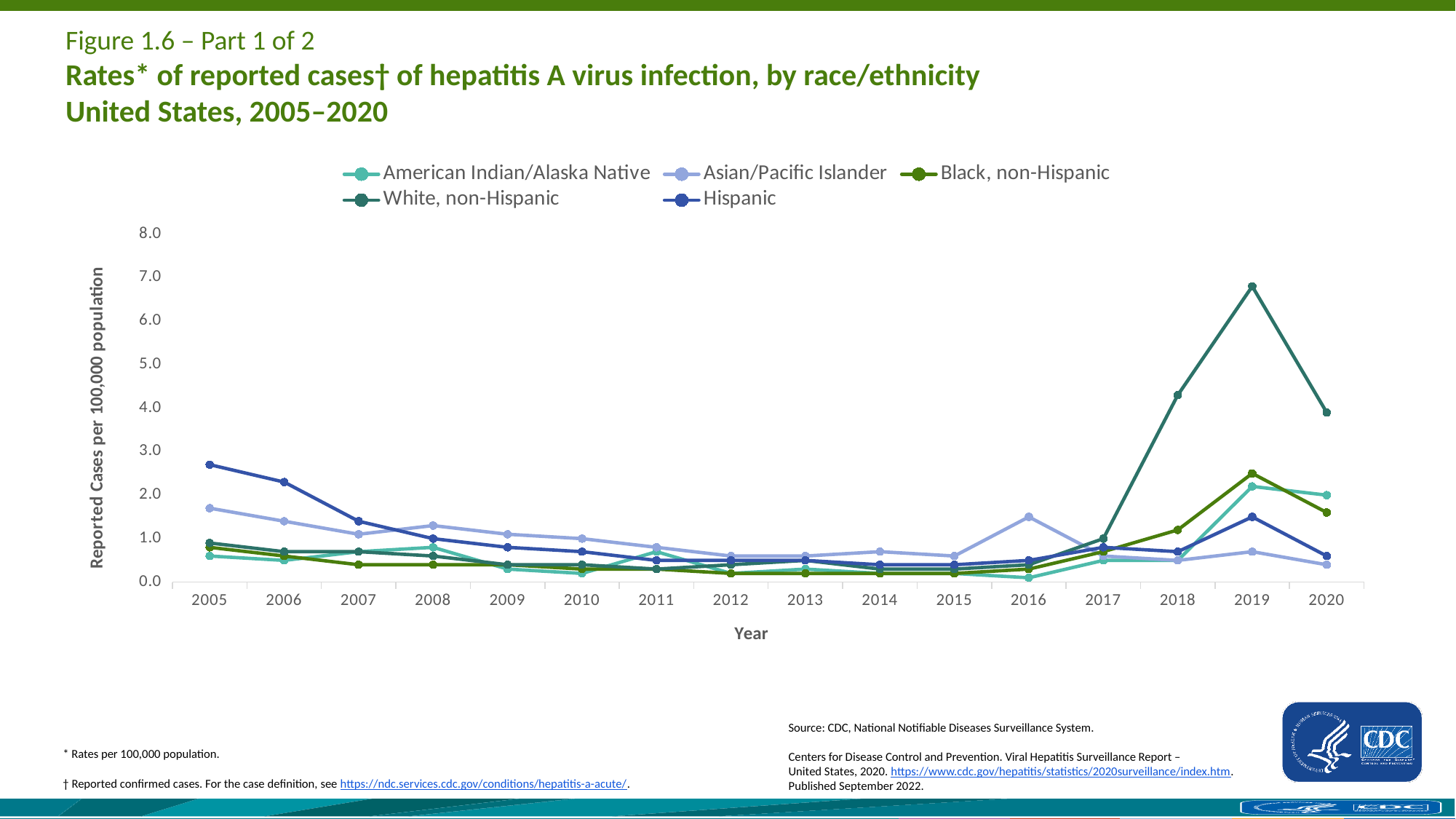
In which year does the White, non-Hispanic line reach its peak? 2019 Is the value for White, non-Hispanic in 2019 greater or less than 6.0? greater How many years are plotted along the x axis? 16 Which race/ethnicity group has the highest rate in 2019? White, non-Hispanic What kind of chart is shown on the slide? line chart How many series does the legend list? 5 Does the Hispanic line rise or fall from 2005 to 2012? fall In 2005, which is larger: the rate for Hispanic or the rate for Asian/Pacific Islander? Hispanic Is the value for White, non-Hispanic in 2020 greater or less than 3.0? greater What is the label of the y axis? Reported Cases per 100,000 population Is the value for Hispanic in 2005 greater or less than 2.0? greater In 2016, which is larger: the rate for Asian/Pacific Islander or the rate for American Indian/Alaska Native? Asian/Pacific Islander